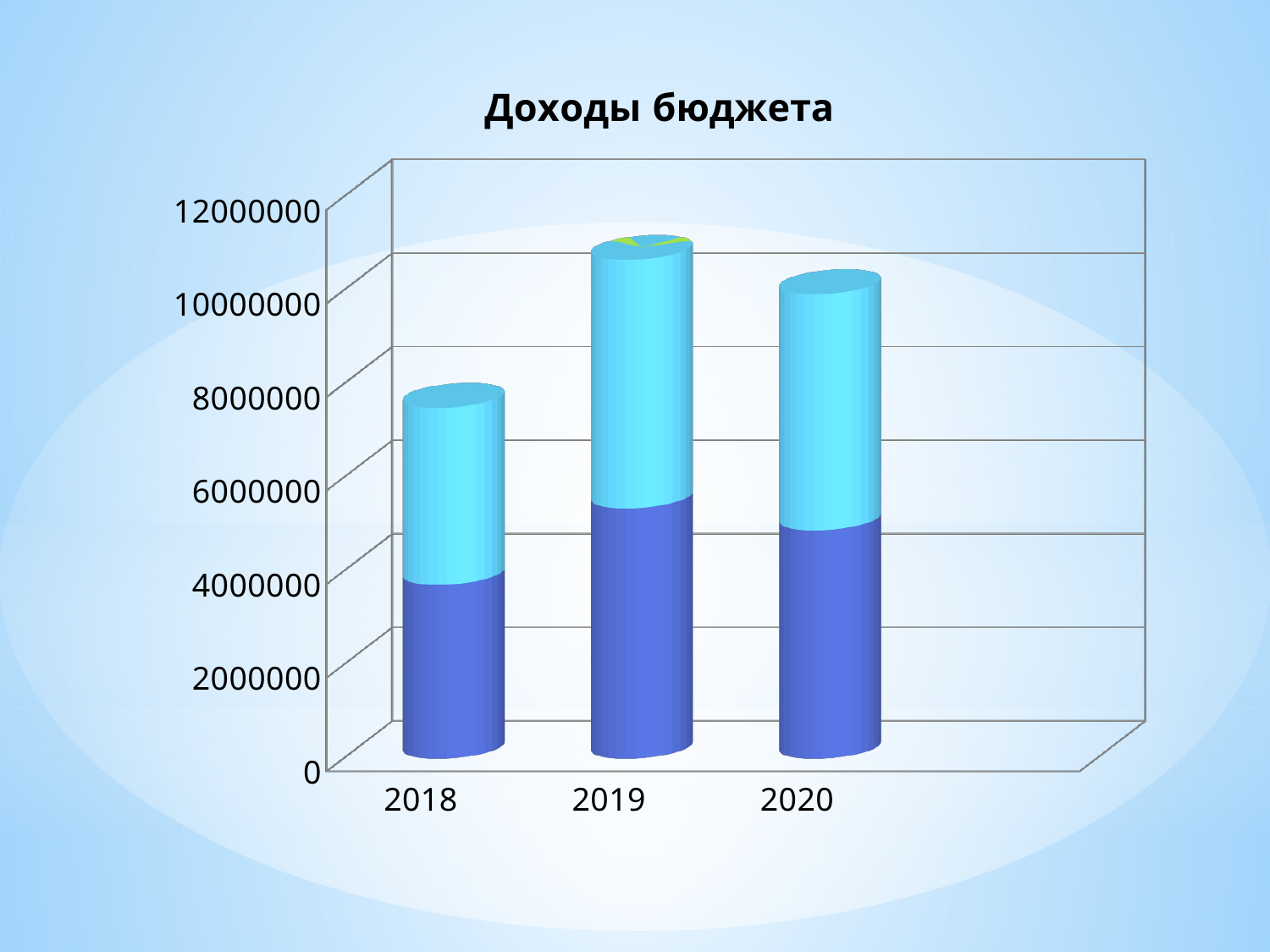
What is the title of the chart? Доходы бюджета How many categories are shown on the x axis of the chart? 3 Is the total value for 2019 greater or less than 10000000? greater Is the total value for 2018 greater or less than 6000000? greater Does the total bar height rise or fall from 2018 to 2019? rise Which bar is taller, 2018 or 2020? 2020 What is the highest value labelled on the vertical axis of the chart? 12000000 What kind of chart is shown on the slide? bar chart Is the total value for 2020 greater or less than 8000000? greater Which year has the tallest bar in the chart? 2019 Which year has the shortest bar in the chart? 2018 Which bar is taller, 2019 or 2020? 2019